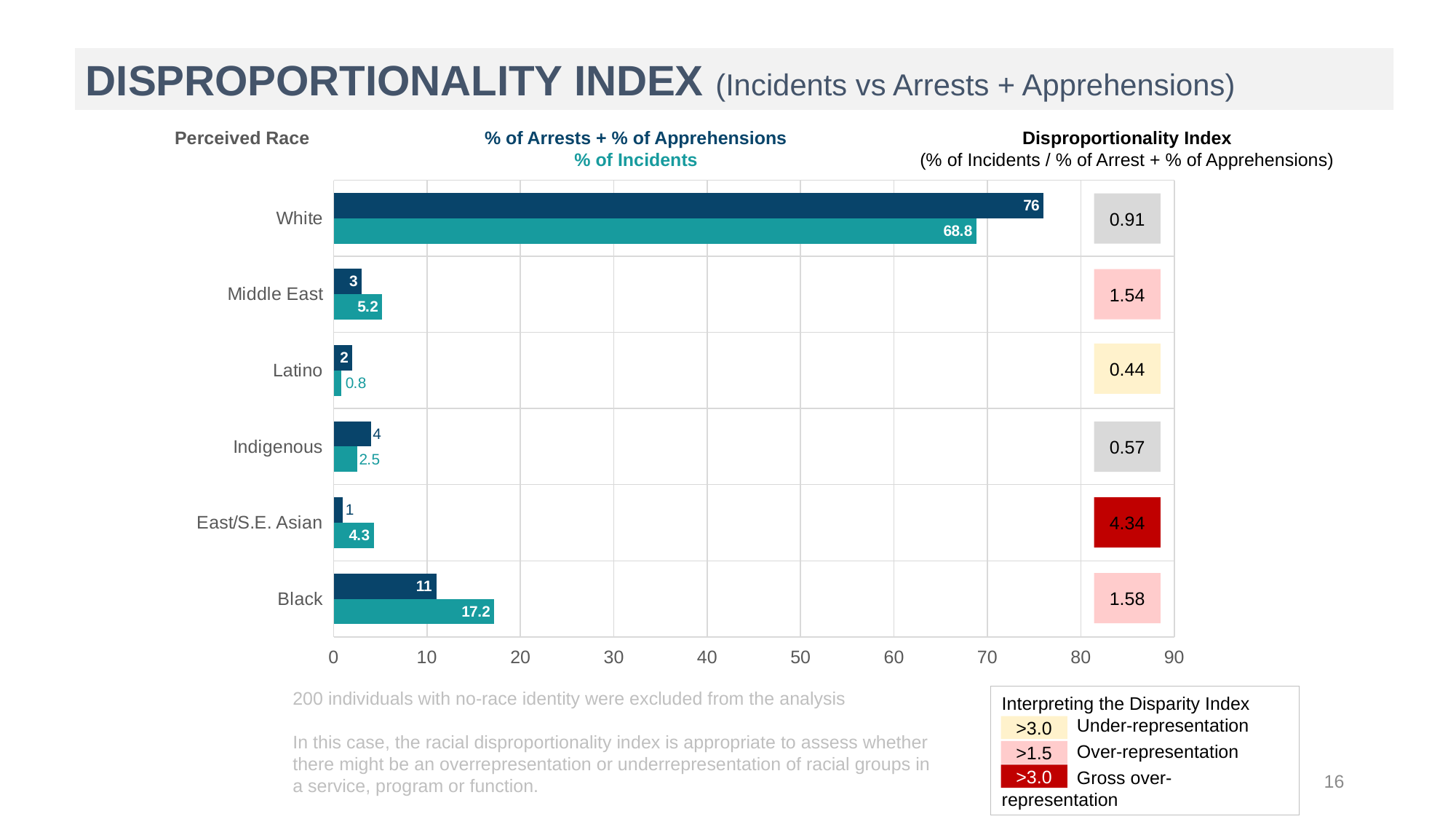
Which perceived race has the highest % of Incidents value? White For Middle East, which is larger: the % of Incidents value or the % of Arrests + % of Apprehensions value? % of Incidents What is the % of Incidents value for East/S.E. Asian? 4.3 Is the % of Incidents value for White greater or less than 60? greater How many data series are plotted in the bar chart? 2 What is the % of Incidents value for Black? 17.2 How many perceived race categories are shown on the chart? 6 What is the % of Arrests + % of Apprehensions value for White? 76 Which perceived race has the lowest % of Arrests + % of Apprehensions value? East/S.E. Asian What is the difference between the % of Incidents and the % of Arrests + % of Apprehensions values for Black? 6.2 What type of chart is shown on the slide? Bar chart What is the Disproportionality Index shown for East/S.E. Asian? 4.34